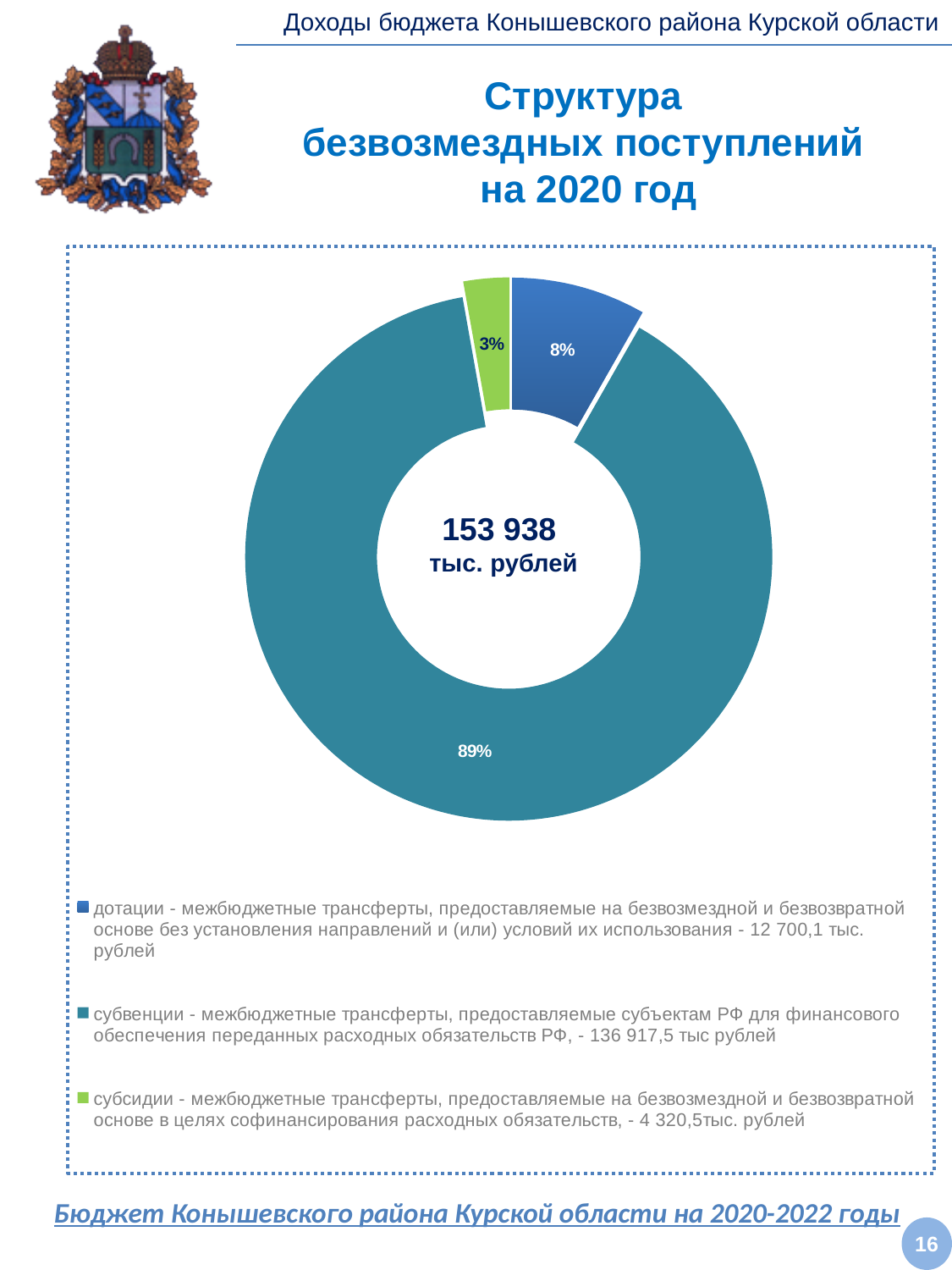
Which category has the smallest slice in the chart? субсидии What share of the donut chart does субвенции account for? 89% How many categories are shown in the donut chart? 3 What share of the donut chart does субсидии account for? 3% According to the legend, what is the amount for дотации? 12 700,1 тыс. рублей What is the total value shown in the centre of the donut chart? 153 938 тыс. рублей What share of the donut chart does дотации account for? 8% Which category has the largest slice in the chart? субвенции According to the legend, what is the amount for субвенции? 136 917,5 тыс рублей What type of chart is shown on the slide? Donut (pie) chart Which is larger in the chart, the share for дотации or the share for субсидии? дотации According to the legend, what is the amount for субсидии? 4 320,5 тыс. рублей